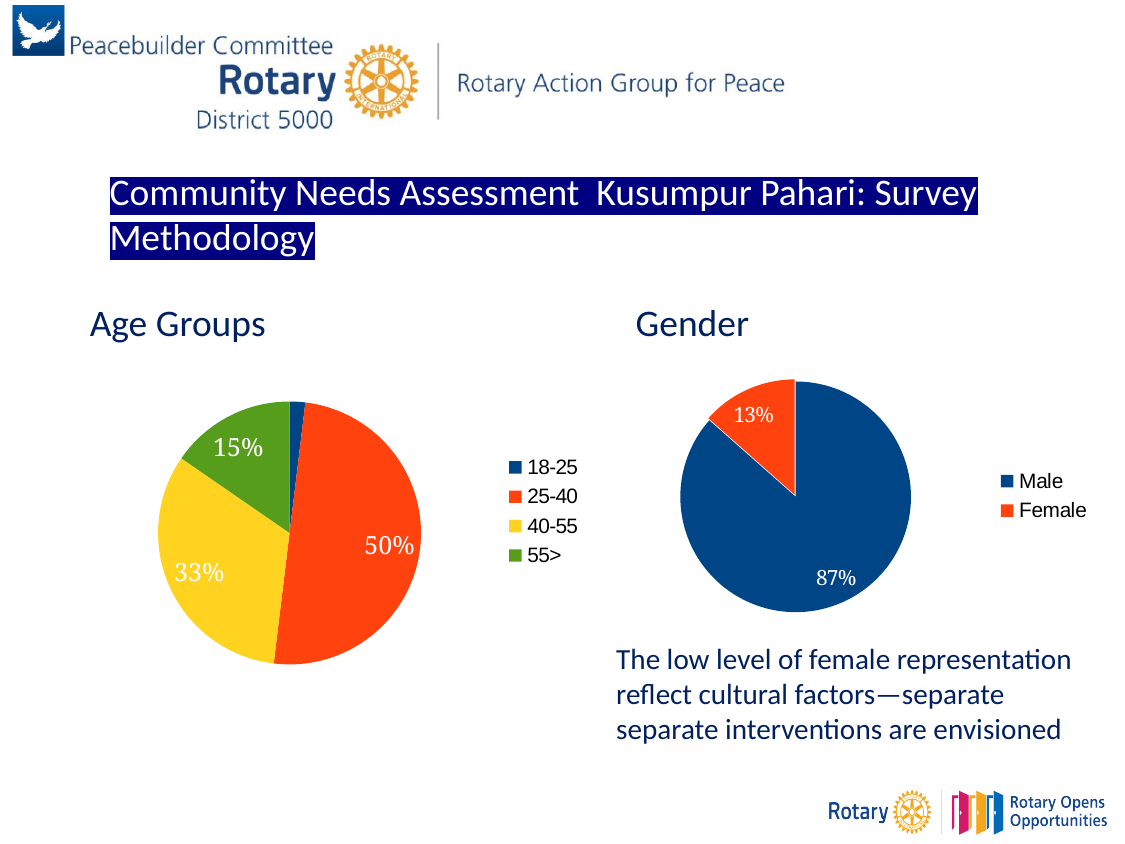
In the Age Groups chart, what share of respondents are aged 40-55? 33% In the Gender chart, what share of respondents are male? 87% In the Age Groups chart, what share of respondents are in the 55> group? 15% In the Age Groups chart, which age group has the smallest share? 18-25 In the Gender chart, what share of respondents are female? 13% In the Age Groups chart, how many age groups does the legend list? 4 In the Age Groups chart, what share of respondents are aged 25-40? 50% In the Age Groups chart, which age group has the largest share? 25-40 In the Age Groups chart, what is the difference in percentage points between the 25-40 and 40-55 groups? 17 In the Gender chart, which is larger, the Male share or the Female share? Male In the Gender chart, what is the difference in percentage points between Male and Female? 74 What type of chart is used for the Gender data? Pie chart